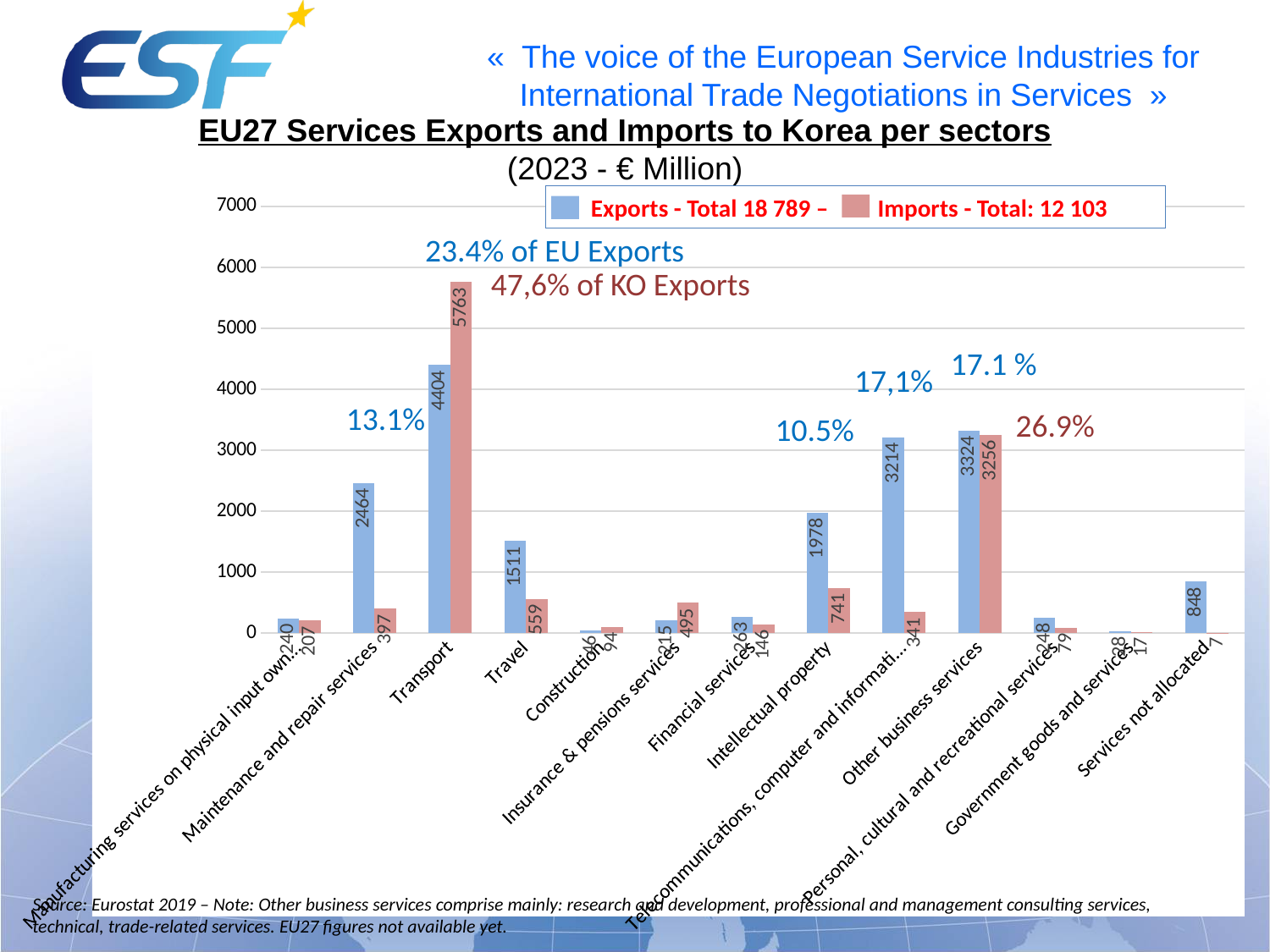
How many series does the legend list? 2 Which sector has the highest Exports value? Transport According to the legend, what is the total of Exports? 18 789 What is the difference between Imports and Exports for Transport? 1359 What kind of chart is shown on the slide? Bar chart For Travel, which is larger: Exports or Imports? Exports What is the difference between Exports and Imports for Intellectual property? 1237 What is the value of Imports for Transport? 5763 What is the value of Exports for Travel? 1511 What is the value of Imports for Intellectual property? 741 Which sector has the highest Imports value? Transport What is the value of Exports for Maintenance and repair services? 2464